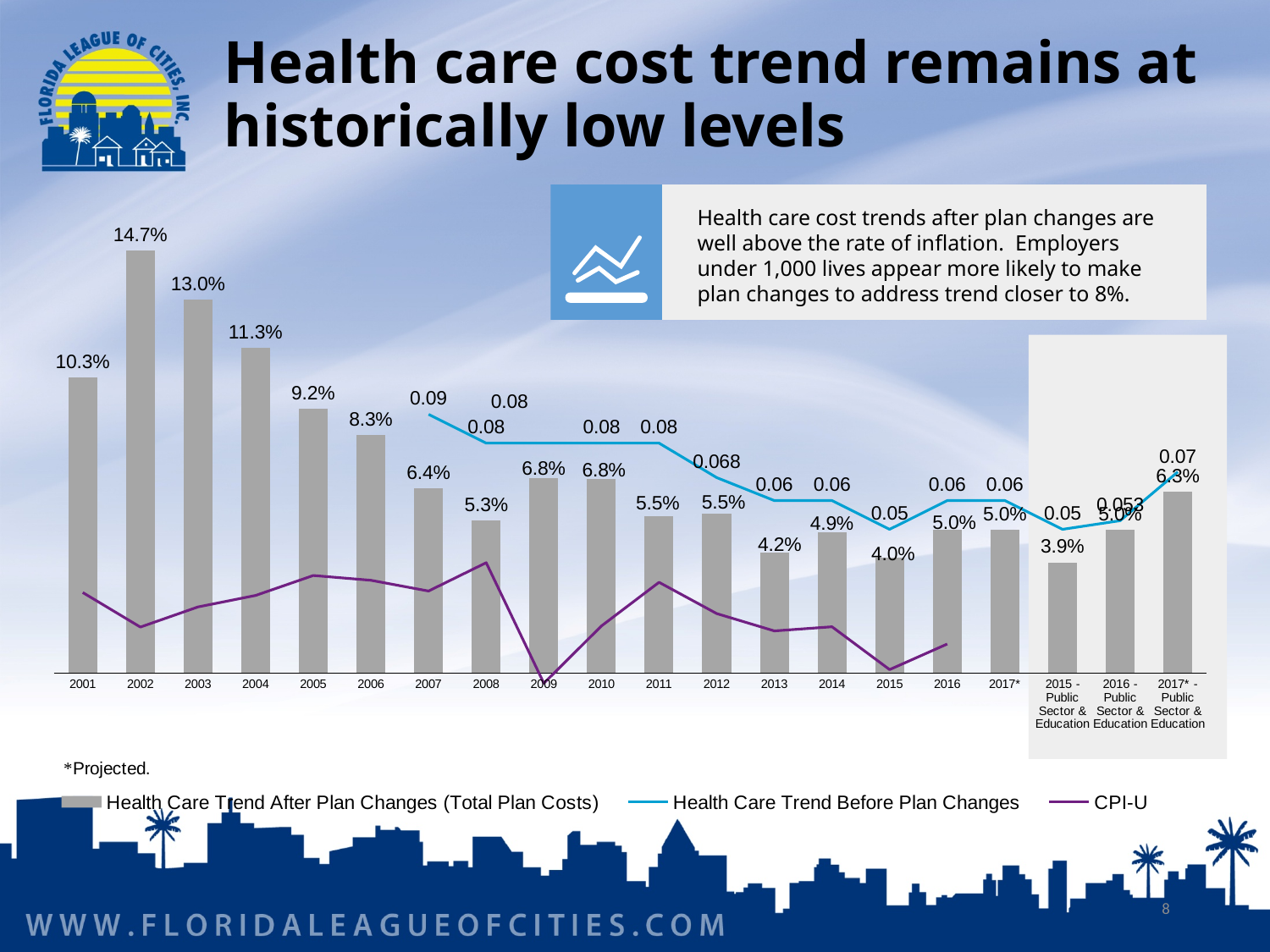
Which category has the lowest Health Care Trend After Plan Changes bar? 2015 - Public Sector & Education What is the Health Care Trend Before Plan Changes value for 2007? 0.09 Which year has the larger Health Care Trend After Plan Changes value, 2013 or 2014? 2014 What kind of chart is used to show Health Care Trend After Plan Changes (Total Plan Costs)? Bar chart What is the difference between the Health Care Trend After Plan Changes values for 2002 and 2003? 1.7% How many categories are shown along the x axis? 20 Which year has the highest Health Care Trend After Plan Changes bar? 2002 Do the Health Care Trend After Plan Changes bars rise or fall from 2002 to 2008? Fall What is the Health Care Trend After Plan Changes value for 2002? 14.7% What is the Health Care Trend Before Plan Changes value for 2012? 0.068 How many series does the legend list? 3 What is the Health Care Trend After Plan Changes value for 2017* - Public Sector & Education? 6.3%